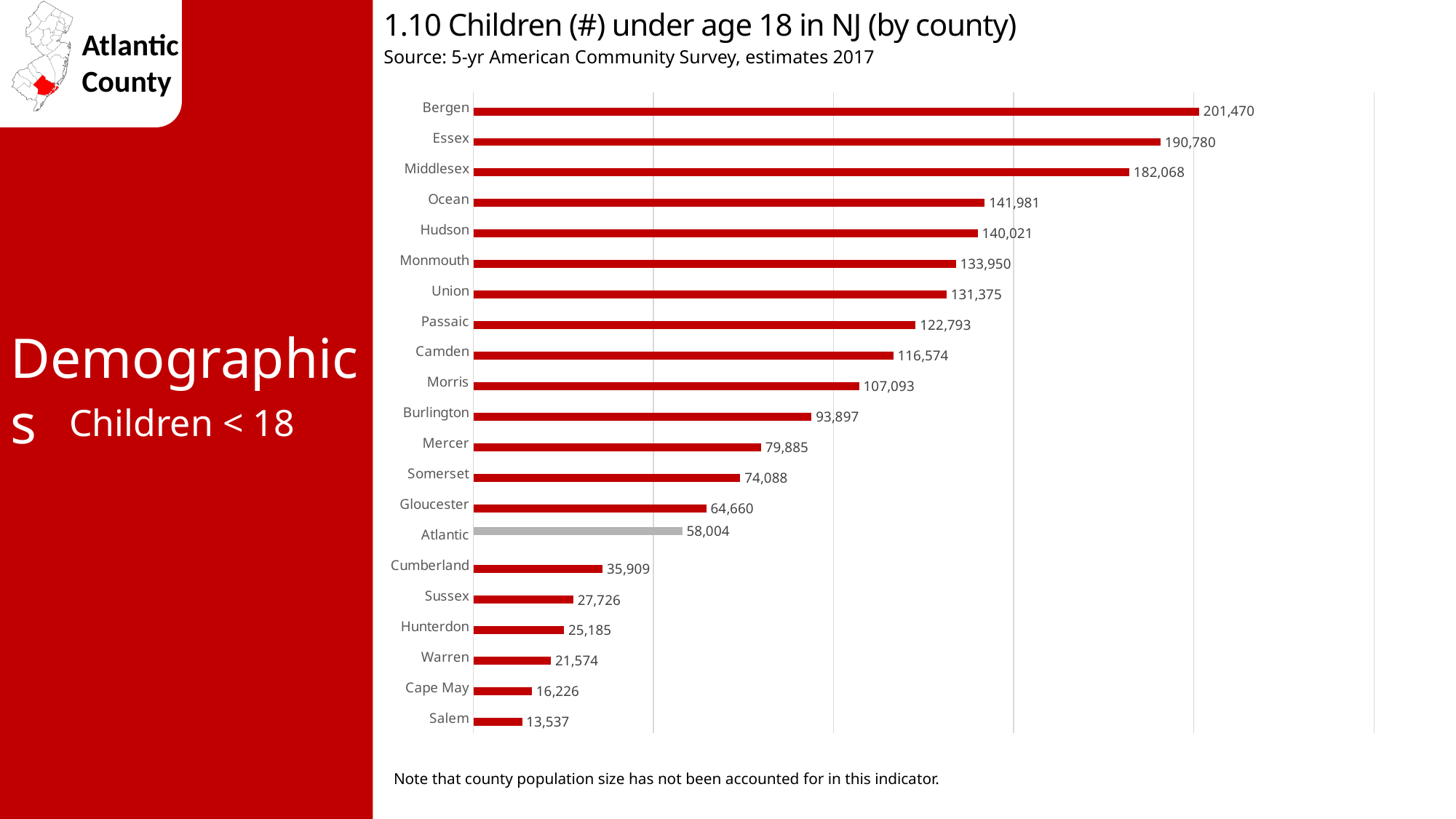
Which county has the highest number of children under age 18? Bergen What is the number of children under age 18 in Atlantic County? 58,004 What is the value shown for Middlesex? 182,068 How many counties are shown in the chart? 21 Which county has the lowest number of children under age 18? Salem What is the difference between the values for Bergen and Essex? 10,690 What is the value shown for Cumberland? 35,909 What kind of chart is shown on the slide? Bar chart Which county's bar is shown in grey rather than red? Atlantic What is the difference between the values for Atlantic and Cumberland? 22,095 Which has a larger value, Camden or Morris? Camden Which has a larger value, Sussex or Warren? Sussex